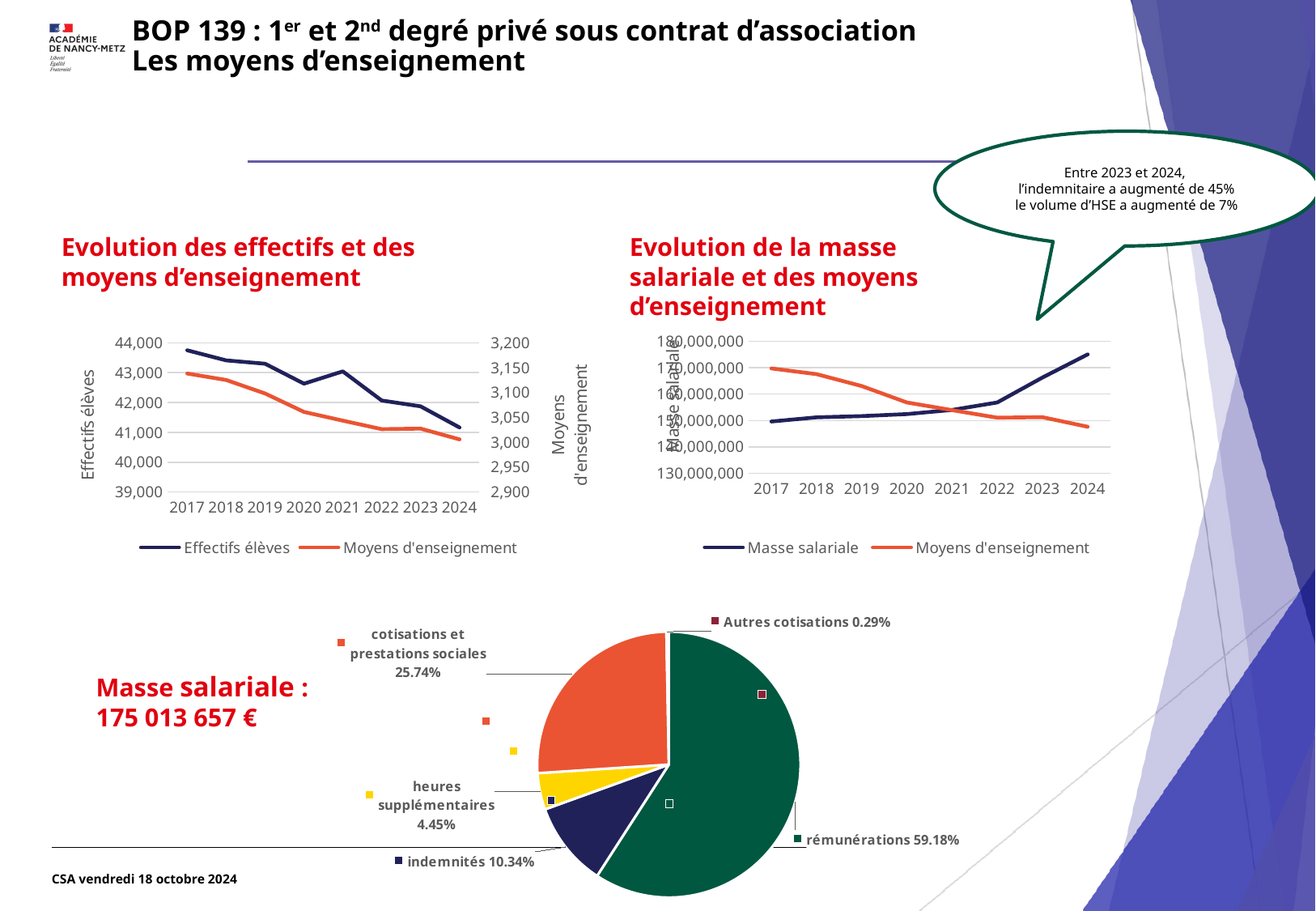
In 'Evolution de la masse salariale et des moyens d'enseignement', does the Masse salariale rise or fall from 2017 to 2024? rise How many series does the legend of 'Evolution des effectifs et des moyens d'enseignement' list? 2 In the pie chart at the bottom of the slide, which category has the smallest share? Autres cotisations In the pie chart at the bottom of the slide, what is the share of heures supplémentaires? 4.45% In the pie chart at the bottom of the slide, what is the difference in percentage points between cotisations et prestations sociales and indemnités? 15.40% In the pie chart at the bottom of the slide, which category has the largest share? rémunérations In the pie chart at the bottom of the slide, what share of the masse salariale is rémunérations? 59.18% How many slices does the pie chart at the bottom of the slide have? 5 In 'Evolution de la masse salariale et des moyens d'enseignement', is the Masse salariale in 2024 greater or less than 170,000,000? greater What kind of chart is 'Evolution des effectifs et des moyens d'enseignement'? line chart In 'Evolution des effectifs et des moyens d'enseignement', do the Effectifs élèves rise or fall from 2017 to 2024? fall